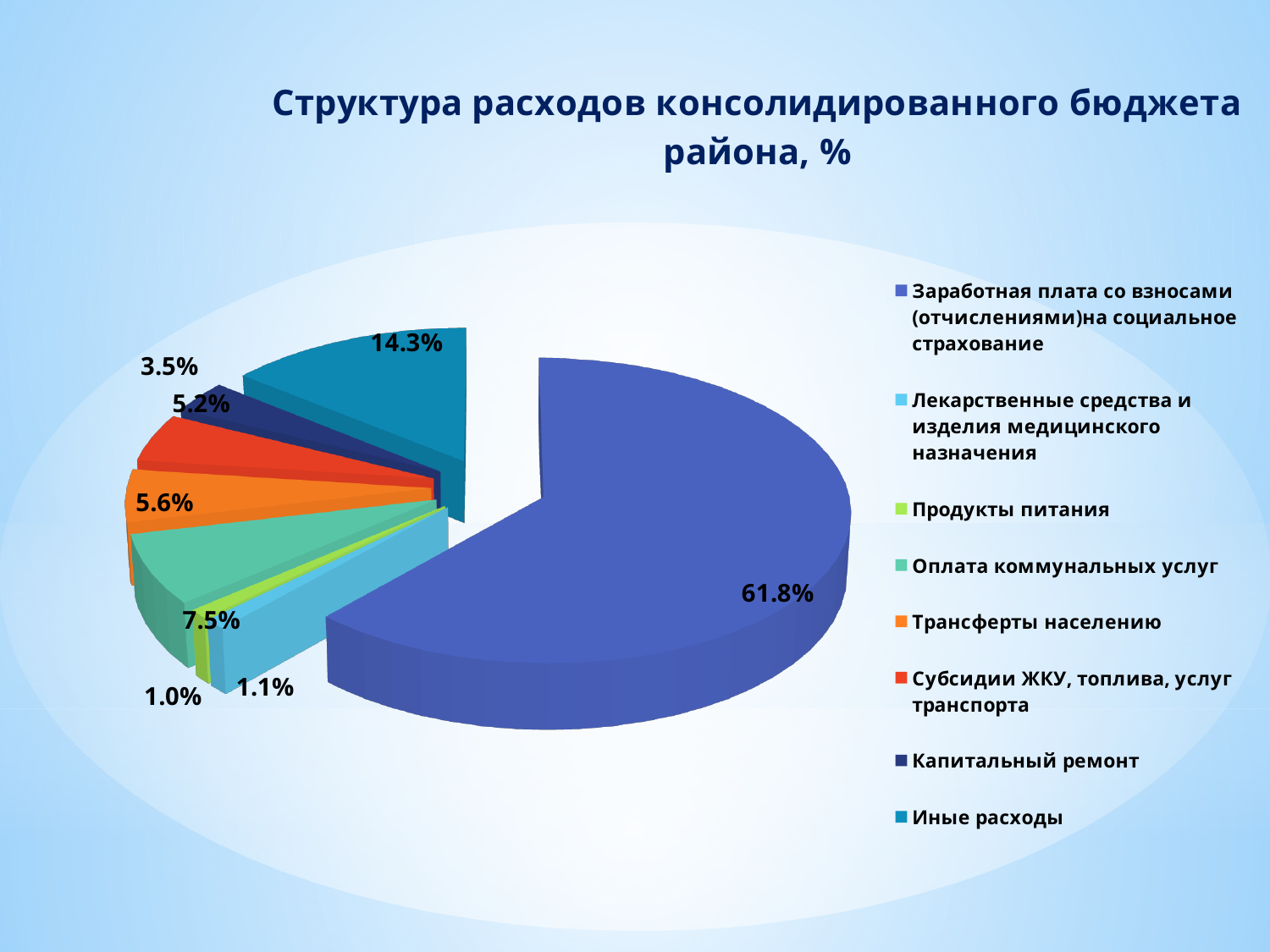
How many categories does the legend list? 8 What is the difference between the shares of "Иные расходы" and "Оплата коммунальных услуг"? 6.8% Which is larger: the share for "Трансферты населению" or for "Субсидии ЖКУ, топлива, услуг транспорта"? Трансферты населению What type of chart is shown on the slide? Pie chart What is the title of the chart? Структура расходов консолидированного бюджета района, % What share of the consolidated budget expenditures goes to "Заработная плата со взносами (отчислениями) на социальное страхование"? 61.8% What is the value for "Оплата коммунальных услуг"? 7.5% What is the difference between the shares of "Лекарственные средства и изделия медицинского назначения" and "Продукты питания"? 0.1% Which category has the largest share of expenditures? Заработная плата со взносами (отчислениями) на социальное страхование What is the value for "Капитальный ремонт"? 3.5% What is the value for "Иные расходы"? 14.3% Which category has the smallest share of expenditures? Продукты питания